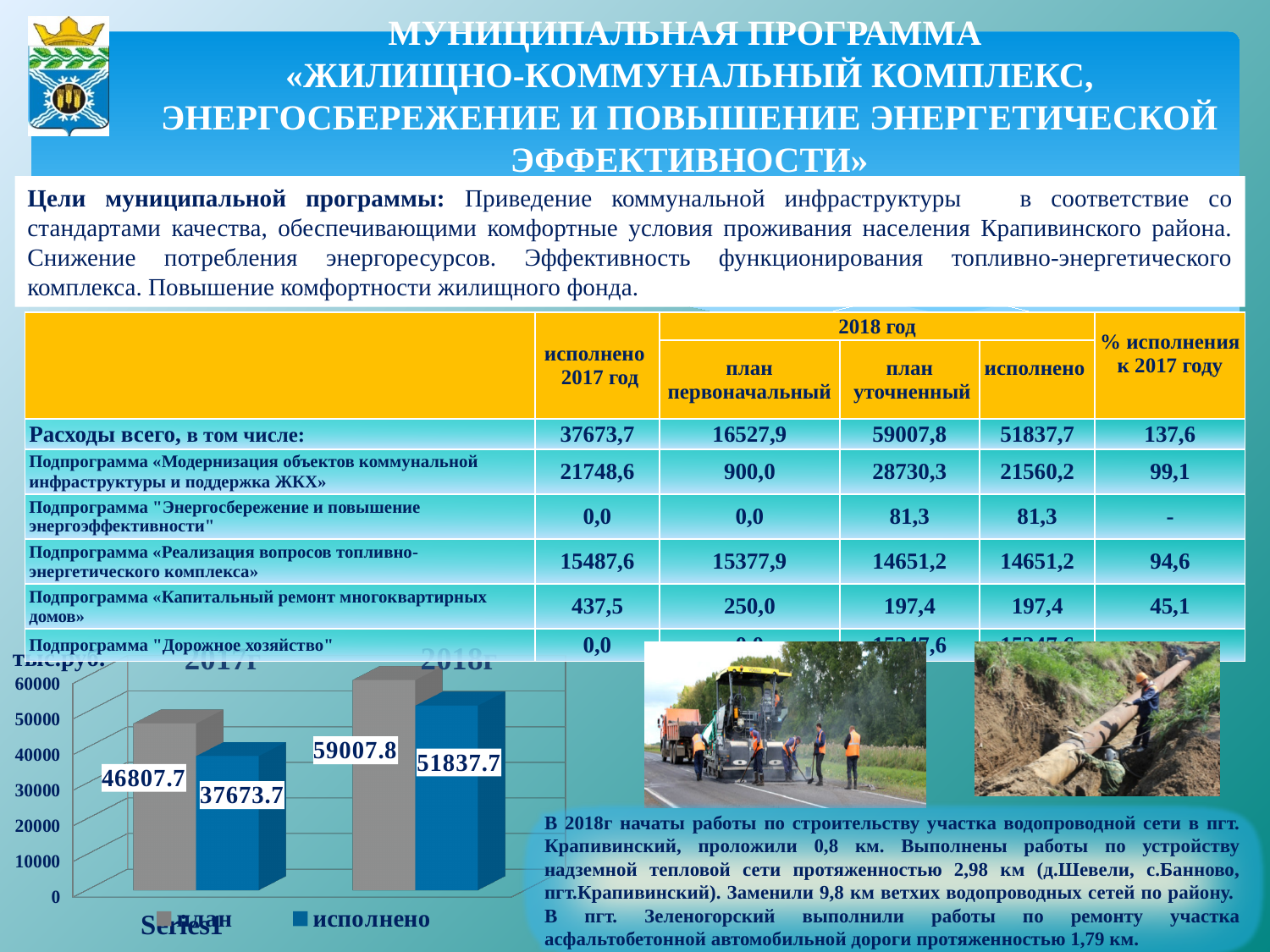
In the bar chart, what is the value of план for 2018г? 59007.8 In the bar chart, what is the value of исполнено for 2018г? 51837.7 In the bar chart, which bar has the lowest value? исполнено for 2017г In the bar chart, what is the difference between план and исполнено for 2018г? 7170.1 In the bar chart, what is the value of исполнено for 2017г? 37673.7 In the bar chart, which bar has the highest value? план for 2018г In the bar chart, does the исполнено value rise or fall from 2017г to 2018г? rise What type of chart is shown at the bottom left of the slide? bar chart How many series does the legend of the bar chart list? 2 In the bar chart, which year has the higher исполнено value? 2018г In the bar chart, what is the difference between план and исполнено for 2017г? 9134.0 In the bar chart, what is the value of план for 2017г? 46807.7